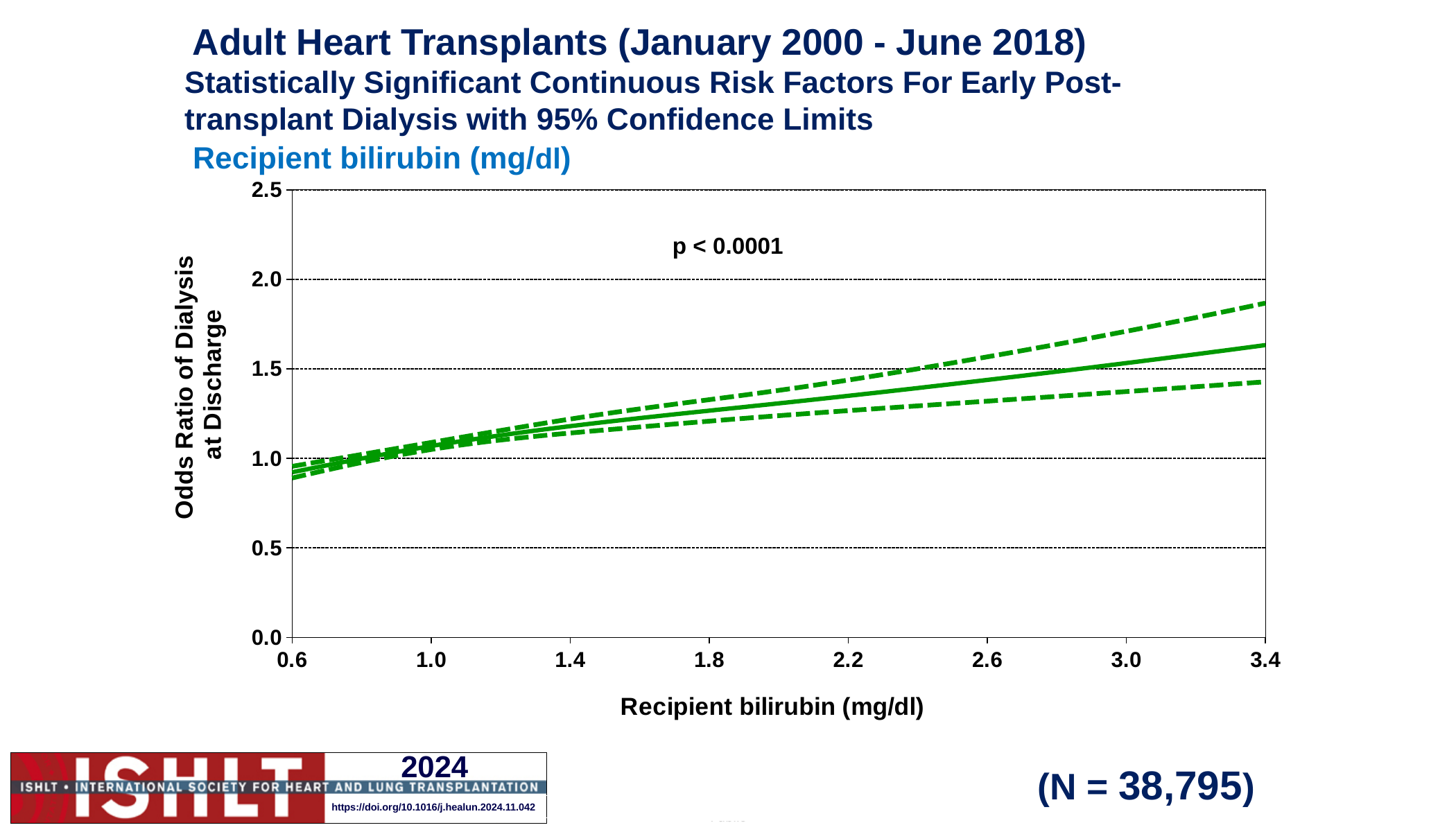
Is the odds ratio (solid line) at a recipient bilirubin of 0.6 mg/dl greater or less than 1.0? less What is the sample size (N) shown on the slide? 38,795 Is the odds ratio (solid line) at a recipient bilirubin of 2.2 mg/dl greater or less than 1.0? greater Is the lower 95% confidence limit at a recipient bilirubin of 3.4 mg/dl greater or less than 1.5? less How many lines are plotted on the chart? 3 What is the highest value shown on the x-axis? 3.4 What is the label of the y-axis? Odds Ratio of Dialysis at Discharge What kind of chart is shown on the slide? Line chart Does the odds ratio of dialysis at discharge rise or fall as recipient bilirubin increases from 0.6 to 3.4 mg/dl? Rise What p-value is printed on the chart? p < 0.0001